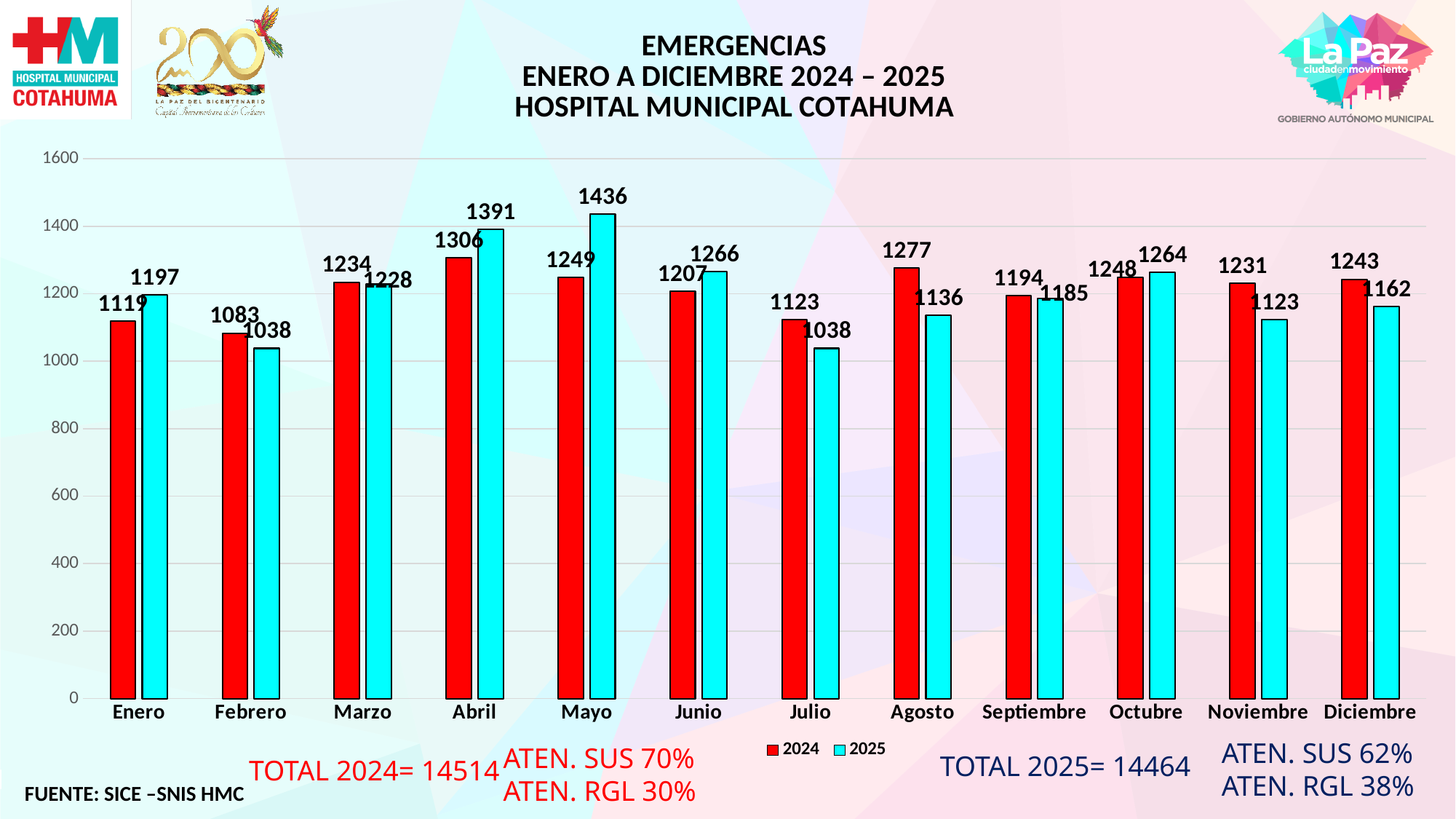
What kind of chart is shown on the slide? Bar chart What is the difference between the 2024 and 2025 values in Agosto? 141 Which month has the highest value for the 2025 series? Mayo What is the value for 2025 in Mayo? 1436 How many months are shown on the x axis? 12 What is the value for 2024 in Febrero? 1083 Which month has the highest value for the 2024 series? Abril What is the difference between the 2025 and 2024 values in Mayo? 187 What is the value for 2024 in Septiembre? 1194 In Noviembre, which series has the larger value, 2024 or 2025? 2024 How many series does the legend list? 2 Which month has the lowest value for the 2024 series? Febrero